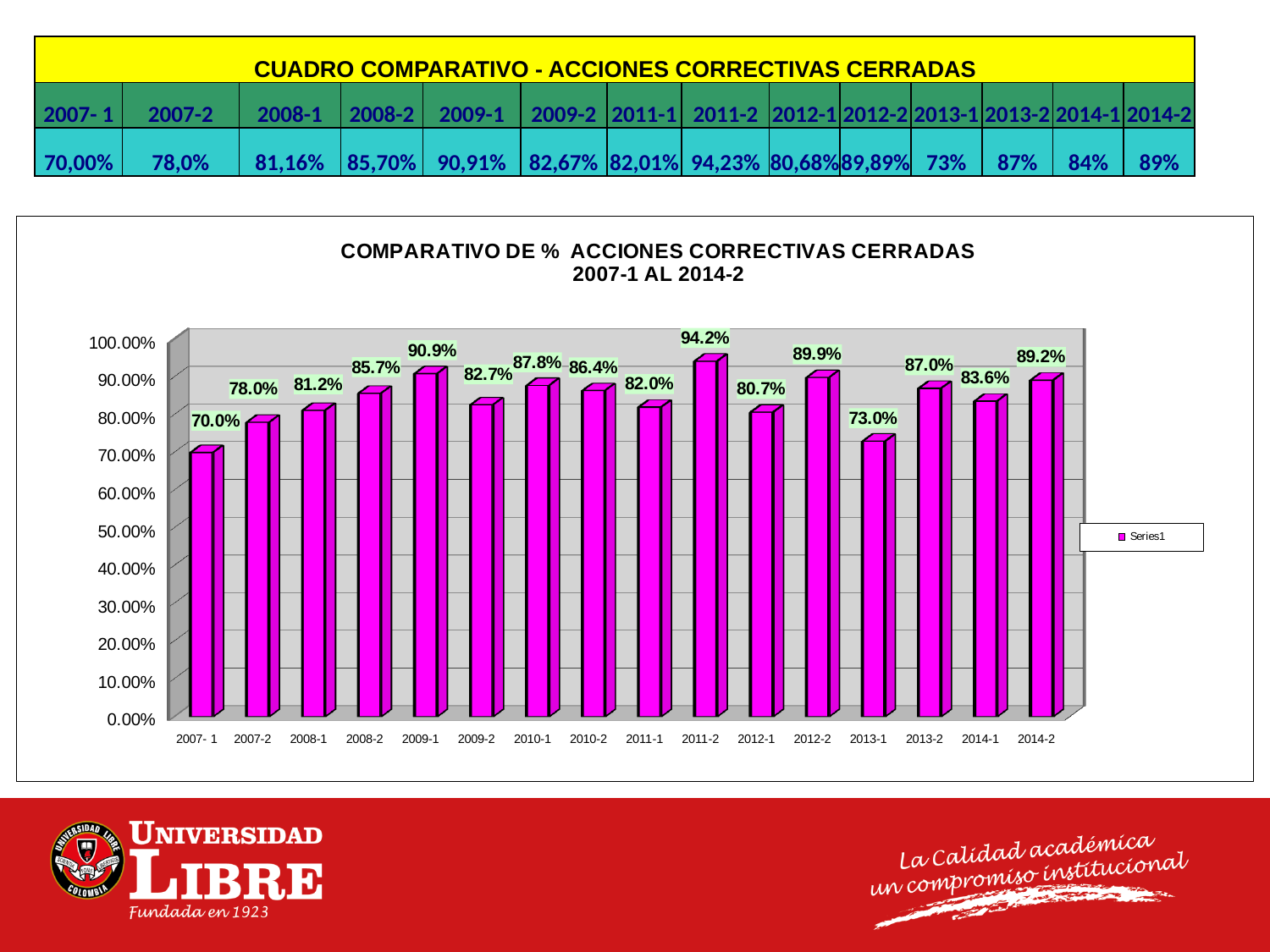
Is the value for 2013-1 greater or less than 80.00%? less How many periods (bars) are shown on the x axis of the chart? 16 Which is larger, the value for 2009-1 or the value for 2012-2? 2009-1 How many series does the chart legend list? 1 What is the value for 2011-2 in the chart? 94.2% What kind of chart is shown on the slide? bar chart Which period has the highest value in the chart? 2011-2 Which period has the lowest value in the chart? 2007- 1 What is the value for 2013-1 in the chart? 73.0% What is the difference between the values for 2011-2 and 2007-1? 24.2% What is the value for 2010-1 in the chart? 87.8% What is the title of the chart? COMPARATIVO DE % ACCIONES CORRECTIVAS CERRADAS 2007-1 AL 2014-2